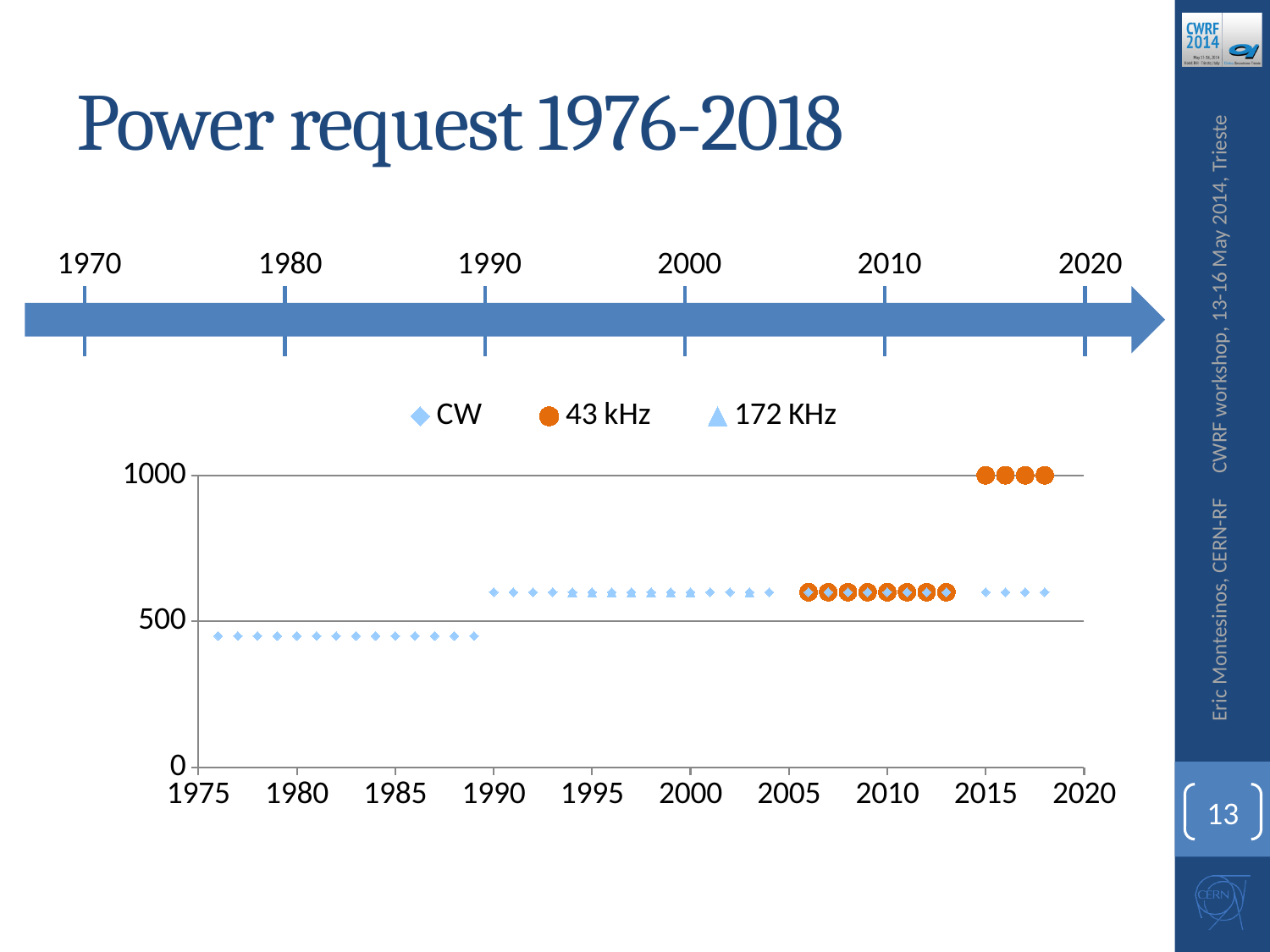
What is the title of the slide containing the chart? Power request 1976-2018 What kind of chart is shown on the slide? scatter chart What is the value of the 43 kHz series in 2016? 1000 In 2016, which series has the larger value, CW or 43 kHz? 43 kHz Is the value for the CW series in 1980 greater or less than 500? less What are the three series named in the chart legend? CW, 43 kHz, 172 KHz Is the value for the CW series in 1995 greater or less than 500? greater How many series does the chart legend list? 3 How many 43 kHz points are plotted at the 1000 level? 4 Do the CW values rise or fall from 1976 to 2018? rise Is the value for the 43 kHz series in 2010 greater or less than 1000? less